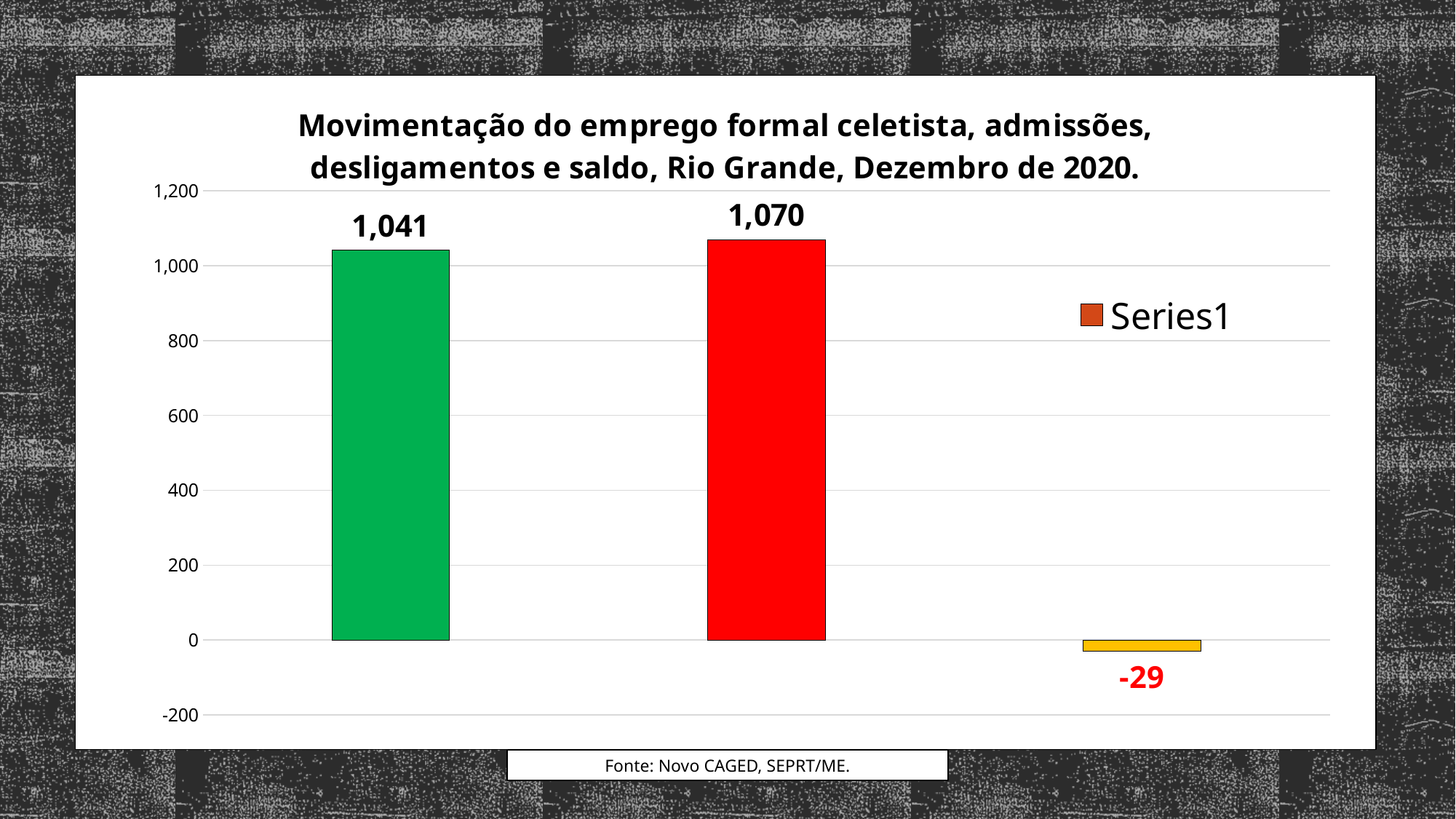
How many bars are plotted in the chart? 3 What is the name of the series shown in the legend? Series1 What is the difference between the value of the red bar and the value of the green bar? 29 What value is printed above the green bar (the first bar from the left)? 1,041 Which is larger, the value of the green bar or the value of the red bar? the red bar Which bar has the lowest value: the green, red or yellow bar? yellow Is the value of the green bar greater or less than 1,000? greater What value is printed below the yellow bar (the rightmost bar)? -29 Which bar has the highest value: the green, red or yellow bar? red What kind of chart is shown on the slide? bar chart How many series does the legend list? 1 What value is printed above the red bar (the middle bar)? 1,070